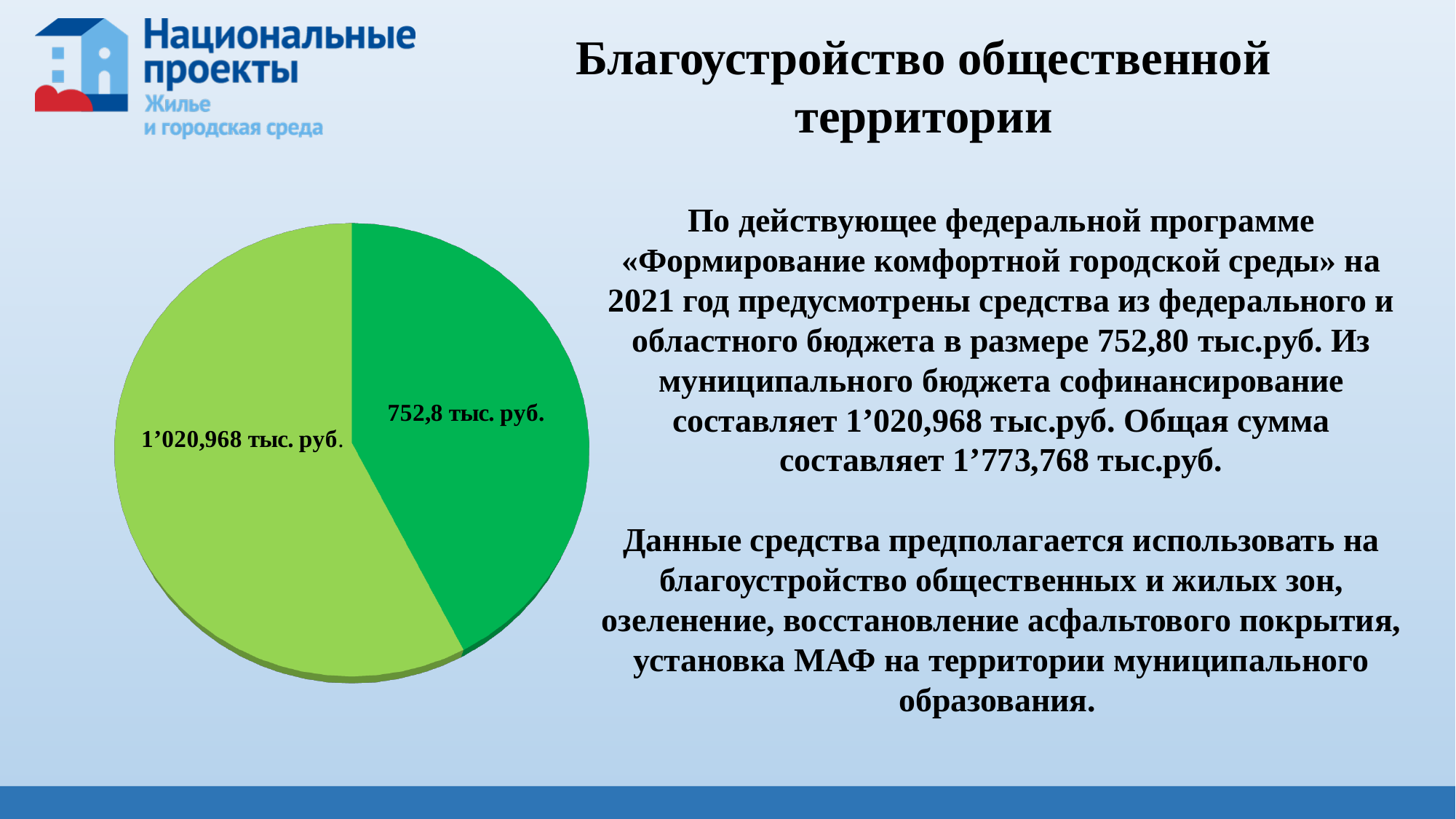
What is the total of the two values shown in the pie chart? 1’773,768 тыс. руб. Which slice of the pie chart is the largest? the light green slice (1’020,968 тыс. руб.) What colours are used for the two slices of the pie chart? light green and dark green What is the difference between the two values shown in the pie chart (1’020,968 and 752,8 тыс. руб.)? 268,168 тыс. руб. How many slices does the pie chart have? 2 Which slice of the pie chart is the smallest? the dark green slice (752,8 тыс. руб.) What is the title of the slide containing the pie chart? Благоустройство общественной территории Which is larger in the pie chart: the light green slice or the dark green slice? the light green slice Is the value of the dark green slice greater or less than 1000 тыс. руб.? less What value is printed on the light green slice of the pie chart? 1’020,968 тыс. руб. What value is printed on the dark green slice of the pie chart? 752,8 тыс. руб. What kind of chart is shown on the slide? pie chart